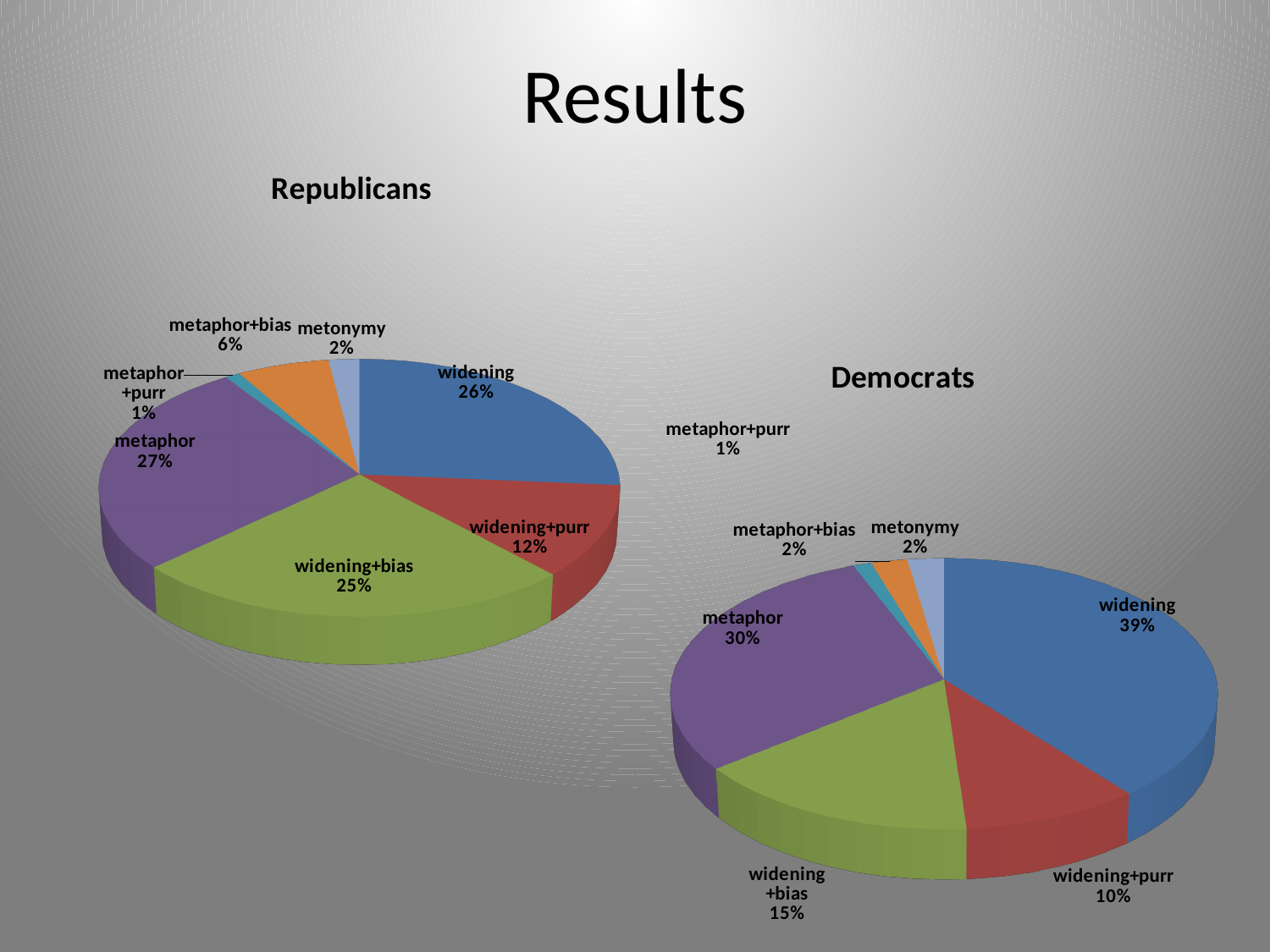
In the Republicans chart, which category has the largest share? metaphor How many categories does the Democrats chart show? 7 In the Democrats chart, what share does widening have? 39% In the Republicans chart, which category has the smallest share? metaphor+purr In the Democrats chart, what is the difference between the shares of metaphor and widening+bias? 15% What kind of chart is the Republicans chart? pie chart In the Republicans chart, what share does widening+bias have? 25% In the Republicans chart, what is the difference between the shares of widening and widening+purr? 14% In the Democrats chart, what share does widening+purr have? 10% In the Democrats chart, which category has the largest share? widening In the Republicans chart, which is larger: metaphor+bias or metonymy? metaphor+bias In the Democrats chart, which category has the smallest share? metaphor+purr